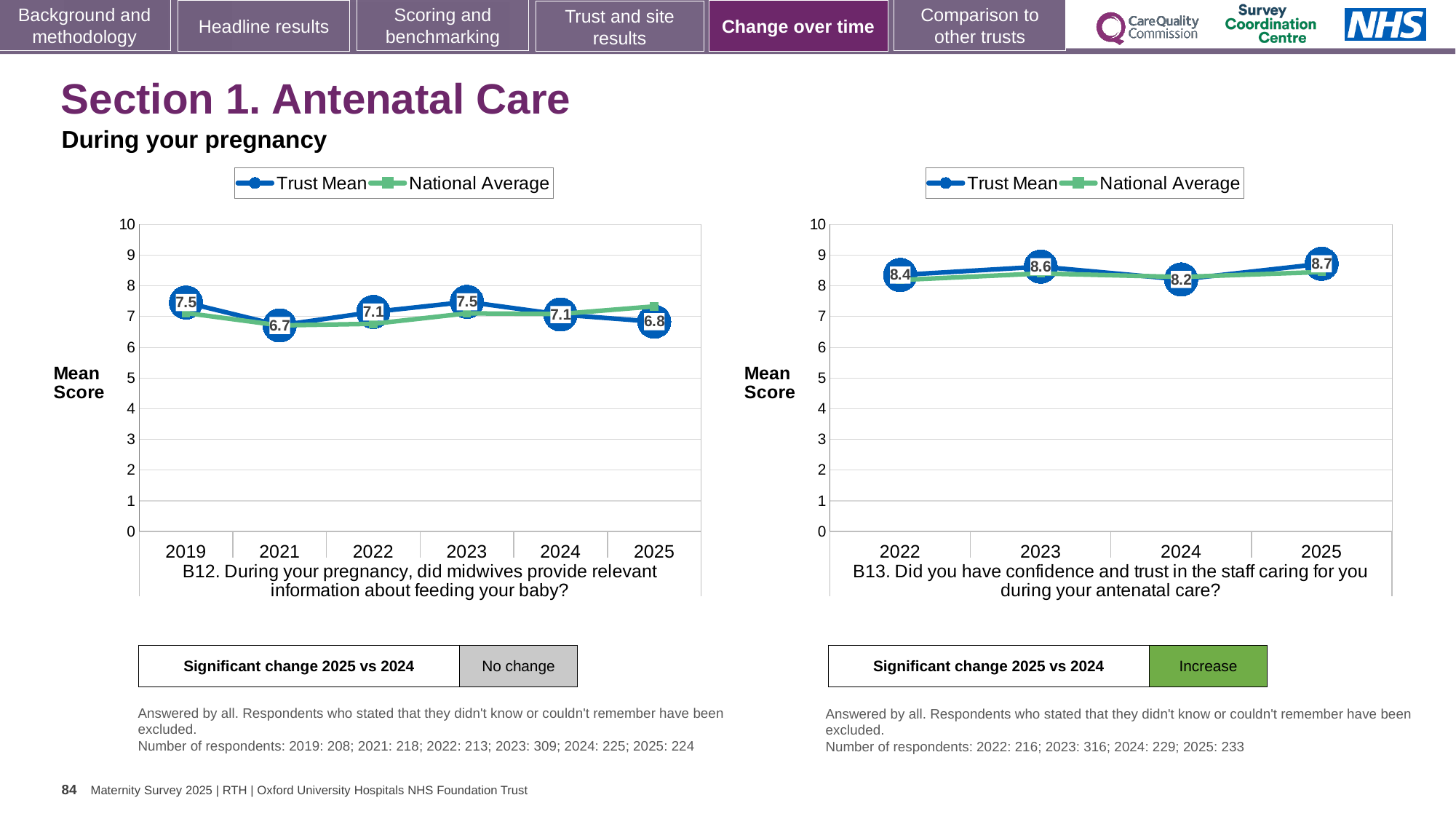
How many series does the legend of the B12 chart on the left list? 2 In the B12 chart on the left, what is the Trust Mean for 2019? 7.5 In the B13 chart on the right, which year has the highest Trust Mean? 2025 In the B12 chart on the left, how many years are shown on the x axis? 6 What kind of chart is the B13 chart on the right? line chart In the B12 chart on the left, which year has the lowest Trust Mean? 2021 In the B12 chart on the left, what is the Trust Mean for 2025? 6.8 In the B12 chart on the left, what is the difference between the Trust Mean in 2023 and in 2021? 0.8 In the B13 chart on the right, is the National Average for 2022 greater or less than 9? less In the B13 chart on the right, what is the Trust Mean for 2024? 8.2 In the B13 chart on the right, is the Trust Mean for 2023 larger or smaller than the Trust Mean for 2024? larger In the B13 chart on the right, what is the difference between the Trust Mean in 2025 and in 2024? 0.5